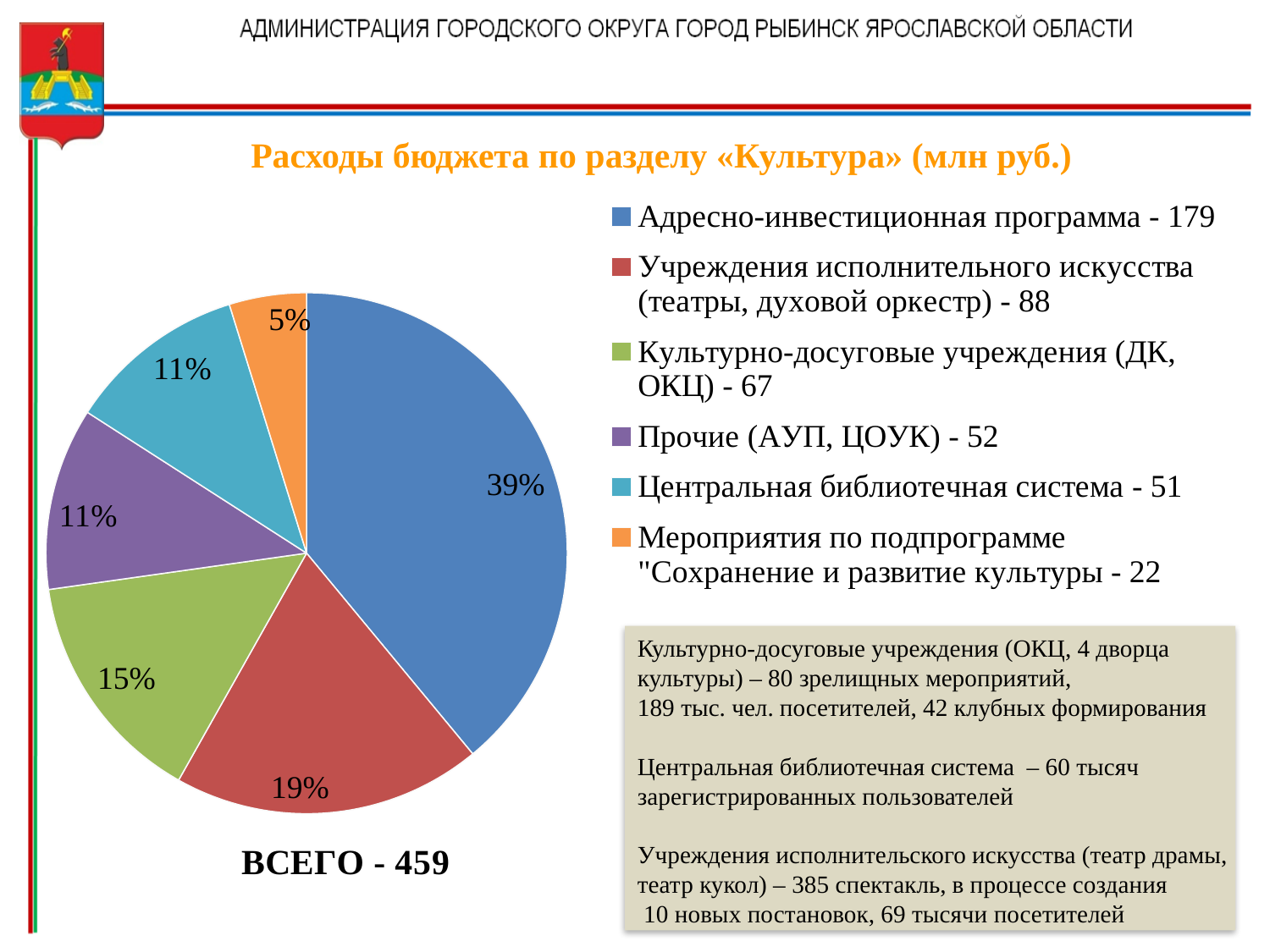
What is the value for Центральная библиотечная система? 51 What total (ВСЕГО) is shown below the pie chart? 459 How many entries does the legend list? 6 Which is larger: Культурно-досуговые учреждения (ДК, ОКЦ) or Прочие (АУП, ЦОУК)? Культурно-досуговые учреждения (ДК, ОКЦ) How many slices does the pie chart have? 6 What share of the pie does Мероприятия по подпрограмме "Сохранение и развитие культуры" take? 5% What kind of chart is shown on the slide? pie chart What is the value for Адресно-инвестиционная программа? 179 Which category has the largest value? Адресно-инвестиционная программа What share of the pie does Культурно-досуговые учреждения (ДК, ОКЦ) take? 15% Which category has the smallest value? Мероприятия по подпрограмме "Сохранение и развитие культуры" What is the difference between the values for Адресно-инвестиционная программа and Учреждения исполнительного искусства (театры, духовой оркестр)? 91